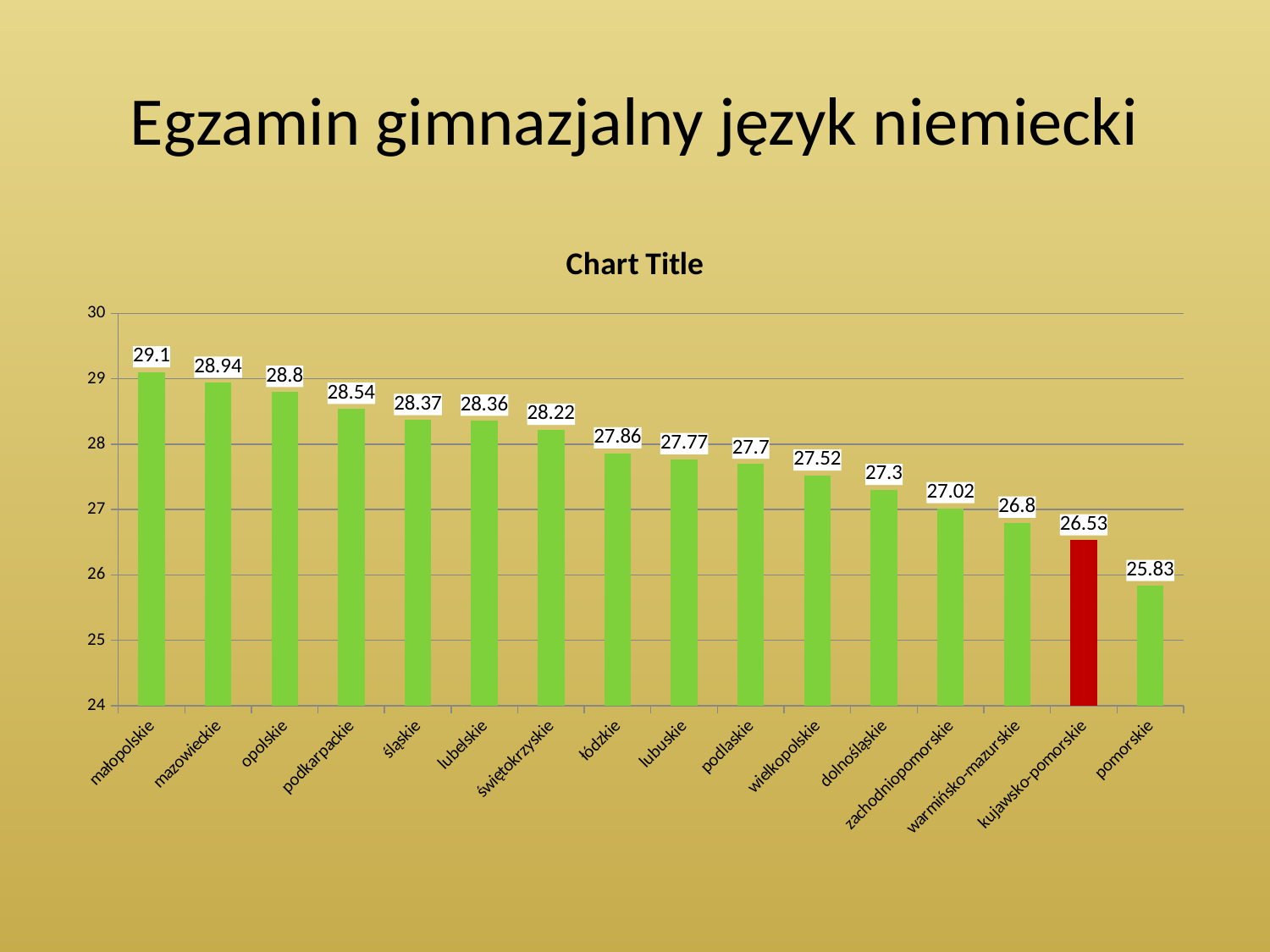
Is the value for warmińsko-mazurskie greater or less than 27? less What is the difference between the values for małopolskie and pomorskie? 3.27 What kind of chart is shown on the slide? bar chart Which is larger, the value for podkarpackie or the value for łódzkie? podkarpackie Which category has the highest value? małopolskie How many categories are shown on the x axis? 16 What is the difference between the values for mazowieckie and opolskie? 0.14 Which bar is coloured red instead of green? kujawsko-pomorskie What is the value for kujawsko-pomorskie? 26.53 What is the value for zachodniopomorskie? 27.02 Which category has the lowest value? pomorskie What is the value for małopolskie? 29.1